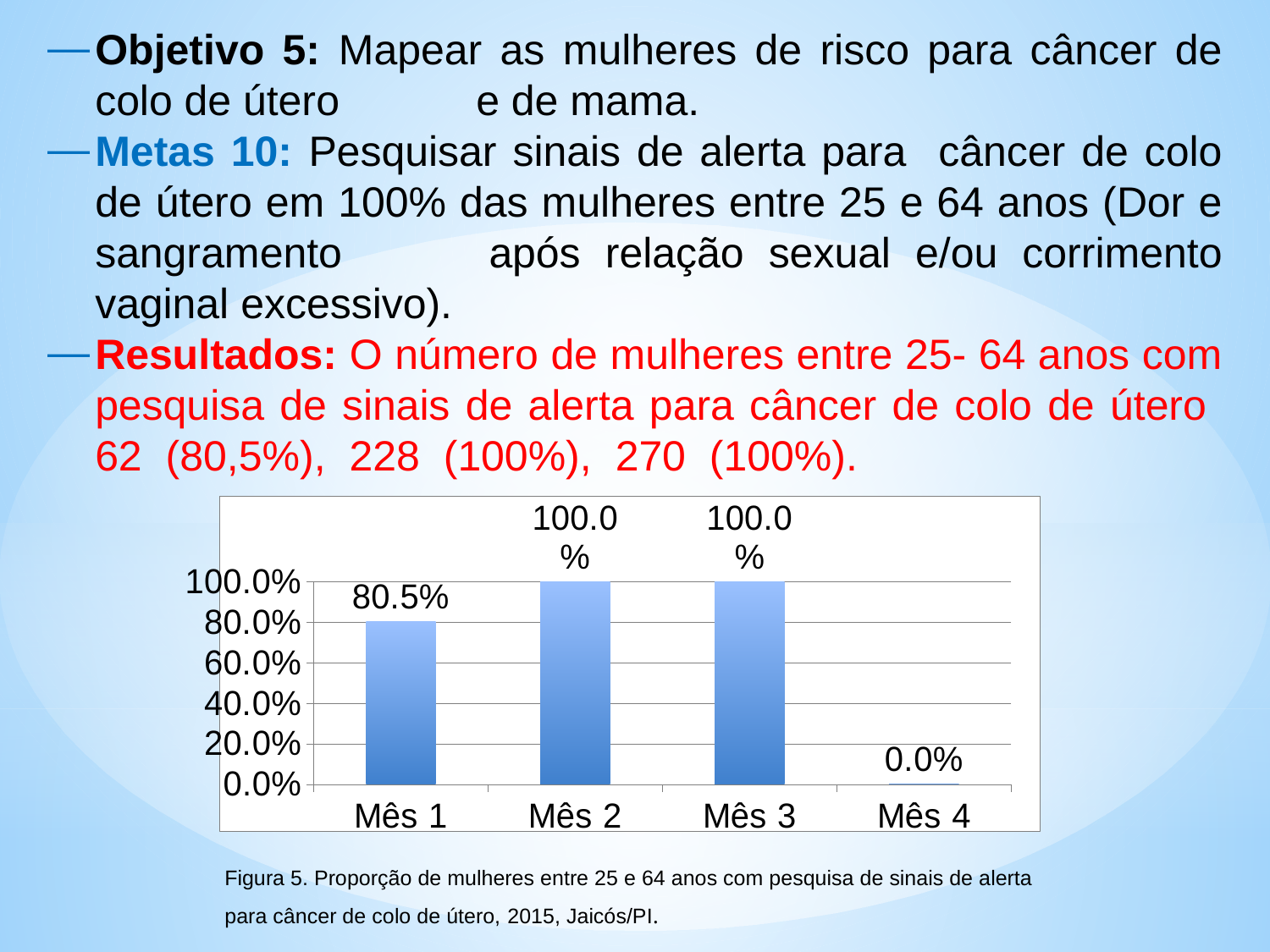
How many categories are shown on the x axis? 4 What is the difference between the values for Mês 2 and Mês 1? 19.5% What is the highest tick value shown on the y axis? 100.0% What kind of chart is shown on the slide? bar chart Is the value for Mês 1 greater or less than 60.0%? greater What is the value for Mês 4? 0.0% Which category has the lowest value? Mês 4 What is the value for Mês 1? 80.5% Does the value rise or fall from Mês 3 to Mês 4? fall Which is larger, the value for Mês 1 or the value for Mês 3? Mês 3 Does the value rise or fall from Mês 1 to Mês 2? rise What is the value for Mês 2? 100.0%